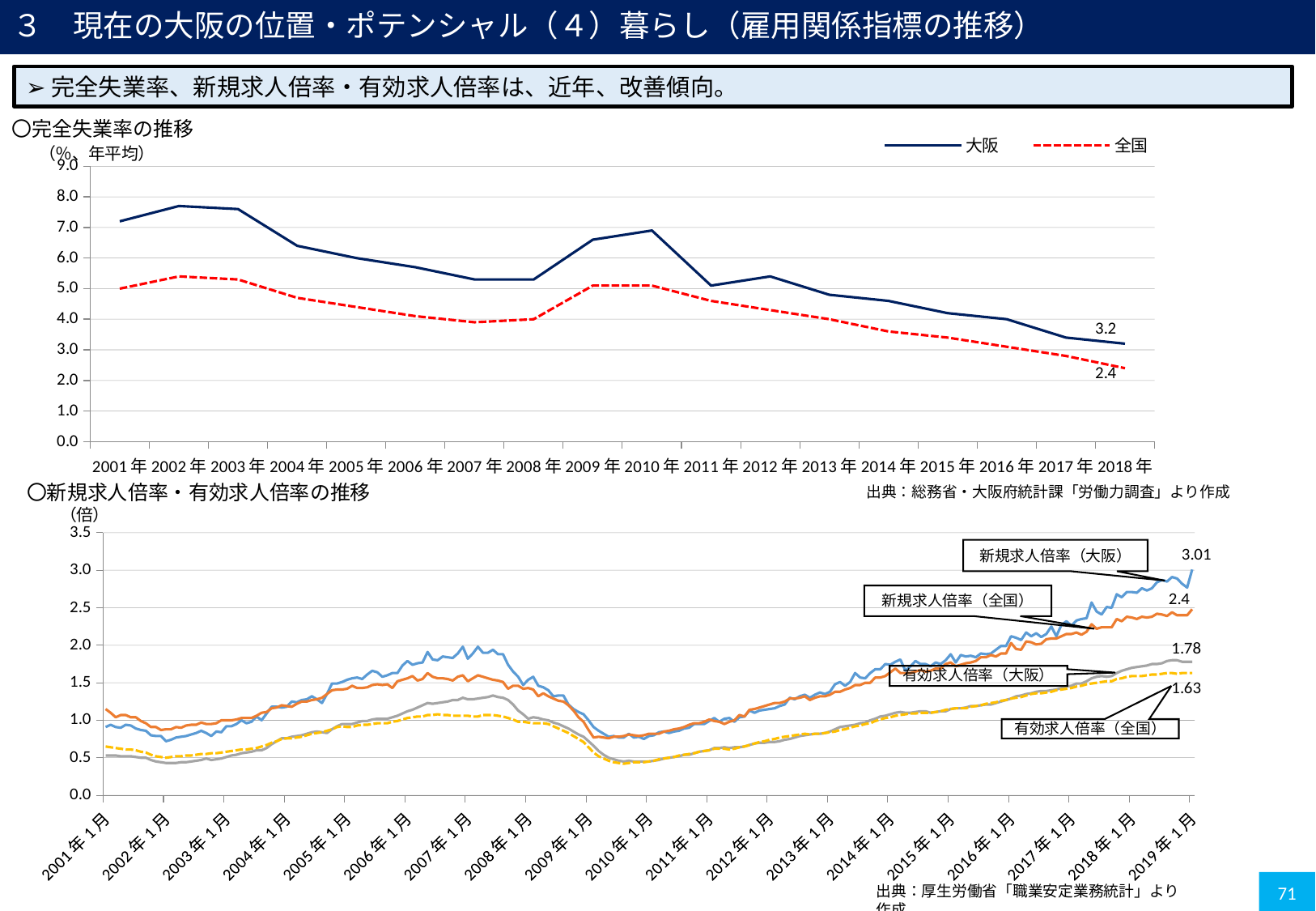
In the top chart (完全失業率の推移), which is larger in 2010年, 大阪 or 全国? 大阪 In the top chart (完全失業率の推移), what is the value for 全国 in 2018年? 2.4 In the top chart (完全失業率の推移), what is the difference between the 大阪 and 全国 values in 2018年? 0.8 In the bottom chart (新規求人倍率・有効求人倍率の推移), what is the difference between the latest labelled values for 有効求人倍率（大阪） and 有効求人倍率（全国）? 0.15 In the top chart (完全失業率の推移), how many years are shown on the x axis? 18 In the bottom chart (新規求人倍率・有効求人倍率の推移), what is the latest labelled value for 有効求人倍率（全国）? 1.63 In the bottom chart (新規求人倍率・有効求人倍率の推移), what is the latest labelled value for 新規求人倍率（大阪）? 3.01 What kind of chart is the bottom chart (新規求人倍率・有効求人倍率の推移)? line chart In the top chart (完全失業率の推移), is the value for 大阪 in 2002年 greater or less than 7.0? greater In the top chart (完全失業率の推移), how many series does the legend list? 2 In the top chart (完全失業率の推移), what is the value for 大阪 in 2018年? 3.2 In the top chart (完全失業率の推移), in which year is the 大阪 value lowest? 2018年